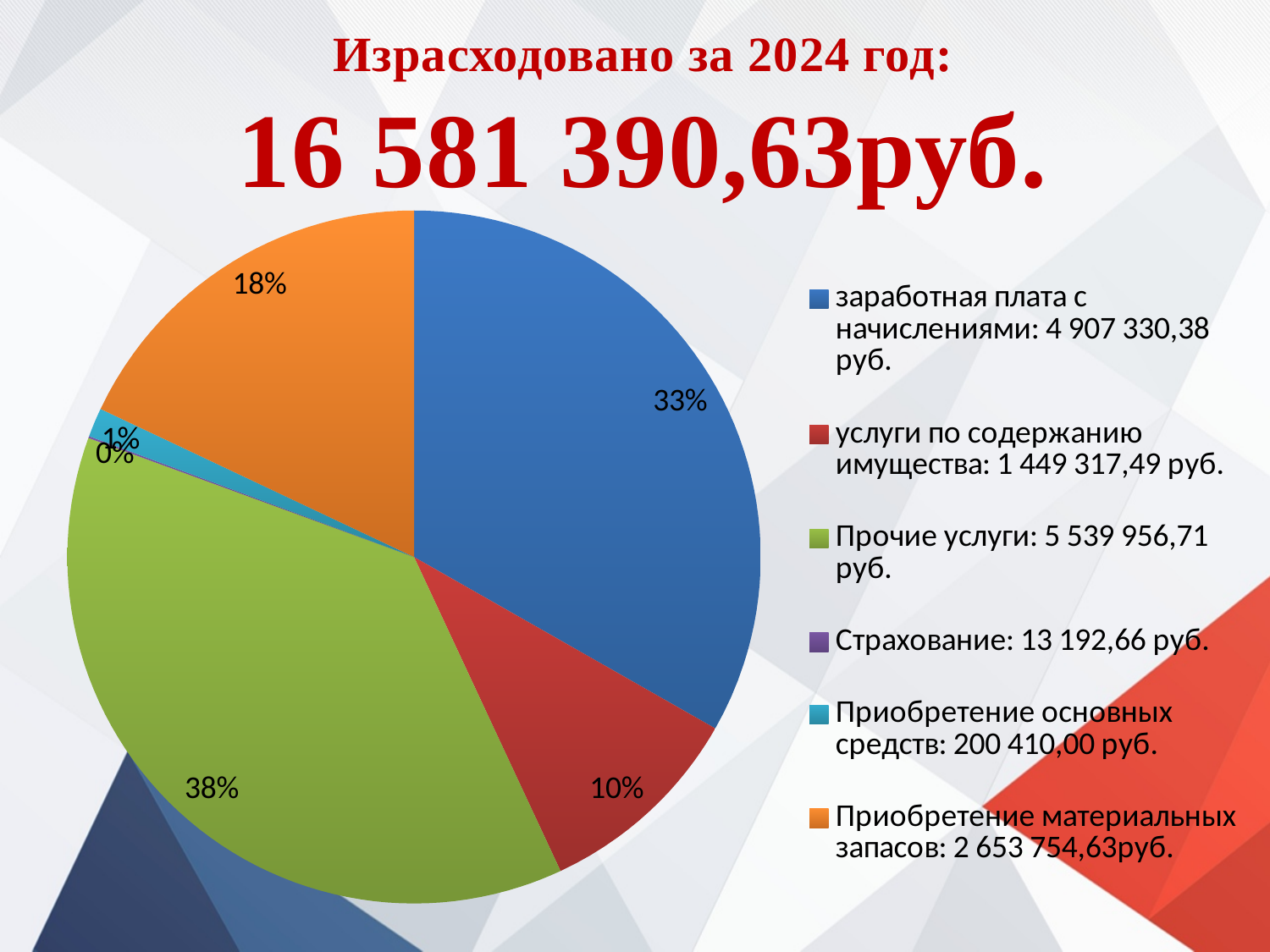
How many categories does the legend of the pie chart list? 6 What kind of chart is shown on the slide? pie chart Which slice is larger: "заработная плата с начислениями" or "Приобретение материальных запасов"? заработная плата с начислениями Which category has the smallest slice of the pie? Страхование What share of the pie does "Приобретение материальных запасов" take? 18% What amount does the legend give for "Страхование"? 13 192,66 руб. What is the difference in percentage points between the "Прочие услуги" slice and the "услуги по содержанию имущества" slice? 28% What share of the pie does "Прочие услуги" take? 38% What share of the pie does "заработная плата с начислениями" take? 33% Which category has the largest slice of the pie? Прочие услуги What colour is the slice for "Приобретение материальных запасов"? orange